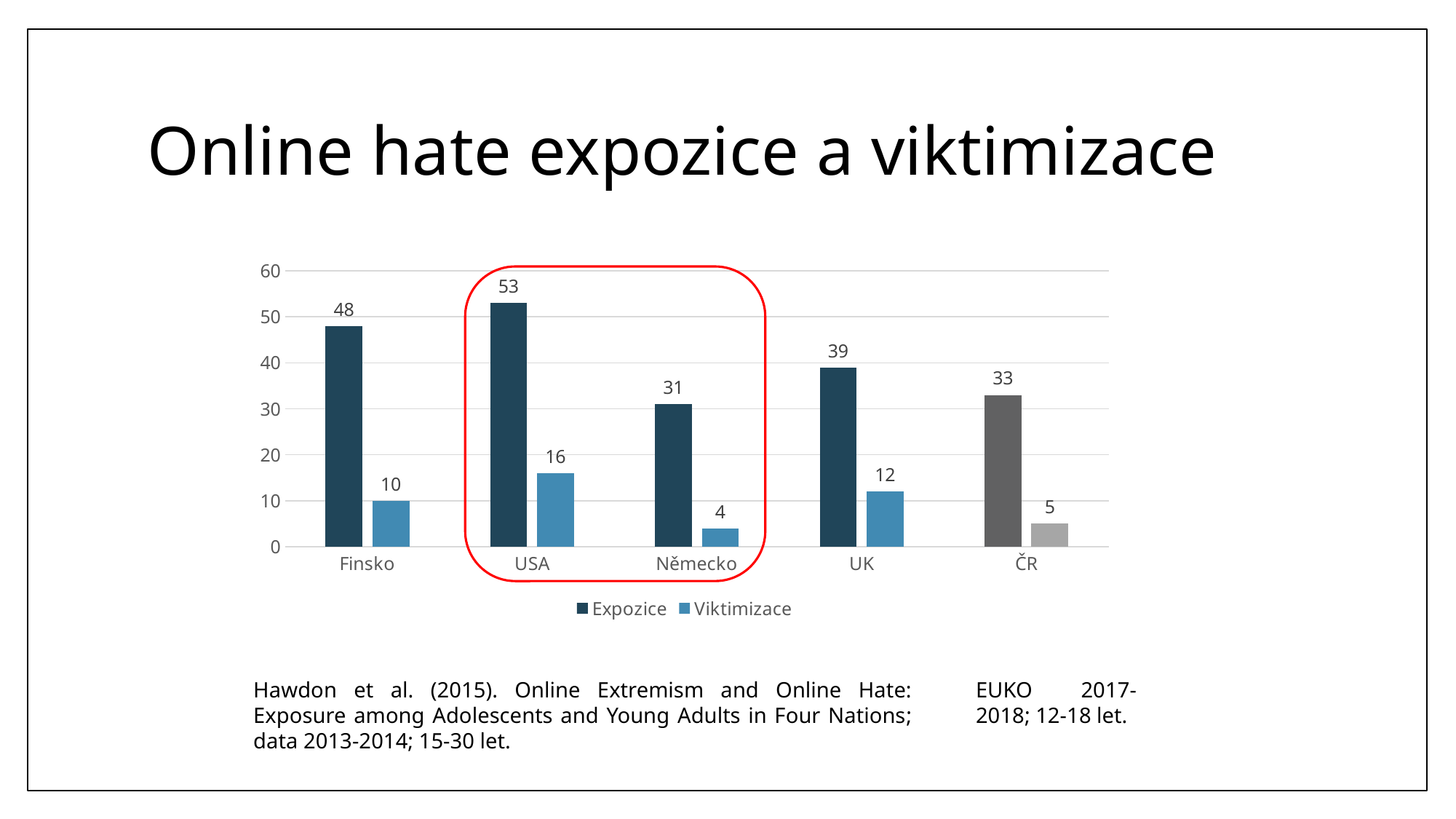
What are the two series named in the legend? Expozice and Viktimizace What kind of chart is shown on the slide? bar chart What is the Viktimizace value for USA? 16 What is the Viktimizace value for Německo? 4 Which countries are enclosed by the red rounded outline on the chart? USA and Německo Which country has the highest Expozice value? USA Which country has the lowest Viktimizace value? Německo What is the difference between the Expozice and Viktimizace values for UK? 27 What is the Expozice value for Finsko? 48 How many series does the legend list? 2 Which is larger, the Expozice value for Finsko or for ČR? Finsko How many countries are shown on the x axis? 5